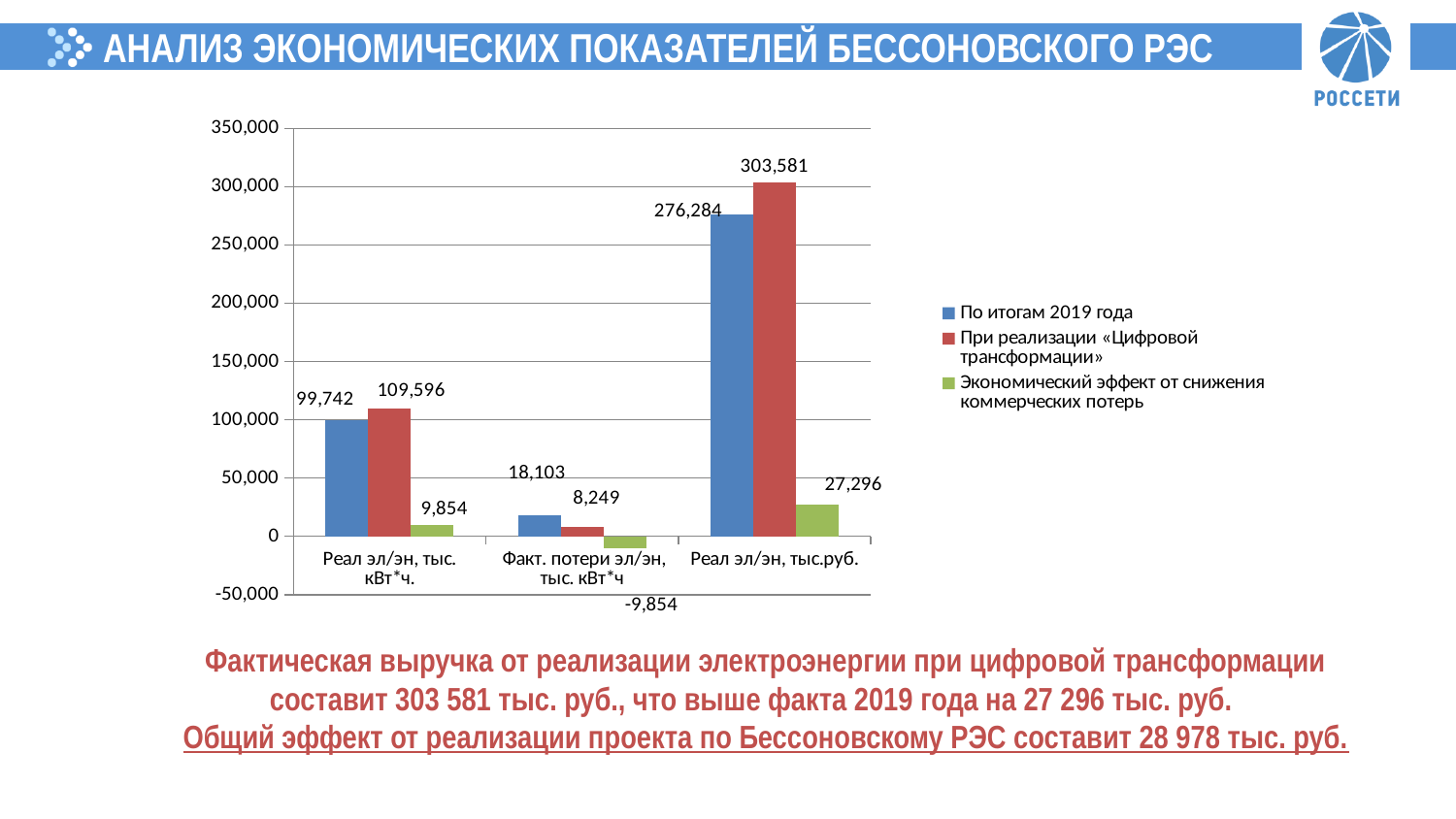
Is the value for «По итогам 2019 года» in the category «Реал эл/эн, тыс.руб.» greater or less than 250,000? greater What is the value for «По итогам 2019 года» in the category «Реал эл/эн, тыс. кВт*ч.»? 99,742 How many categories are shown on the x axis of the chart? 3 What is the difference between «При реализации «Цифровой трансформации»» and «По итогам 2019 года» in the category «Реал эл/эн, тыс.руб.»? 27,297 What is the value for «При реализации «Цифровой трансформации»» in the category «Реал эл/эн, тыс.руб.»? 303,581 What is the value for «По итогам 2019 года» in the category «Факт. потери эл/эн, тыс. кВт*ч»? 18,103 What type of chart is shown on the slide? bar chart How many series does the chart legend list? 3 What is the value for «Экономический эффект от снижения коммерческих потерь» in the category «Факт. потери эл/эн, тыс. кВт*ч»? -9,854 In the category «Факт. потери эл/эн, тыс. кВт*ч», which is larger: «По итогам 2019 года» or «При реализации «Цифровой трансформации»»? По итогам 2019 года Which category has the lowest value for the series «Экономический эффект от снижения коммерческих потерь»? Факт. потери эл/эн, тыс. кВт*ч Which category has the highest value for the series «При реализации «Цифровой трансформации»»? Реал эл/эн, тыс.руб.